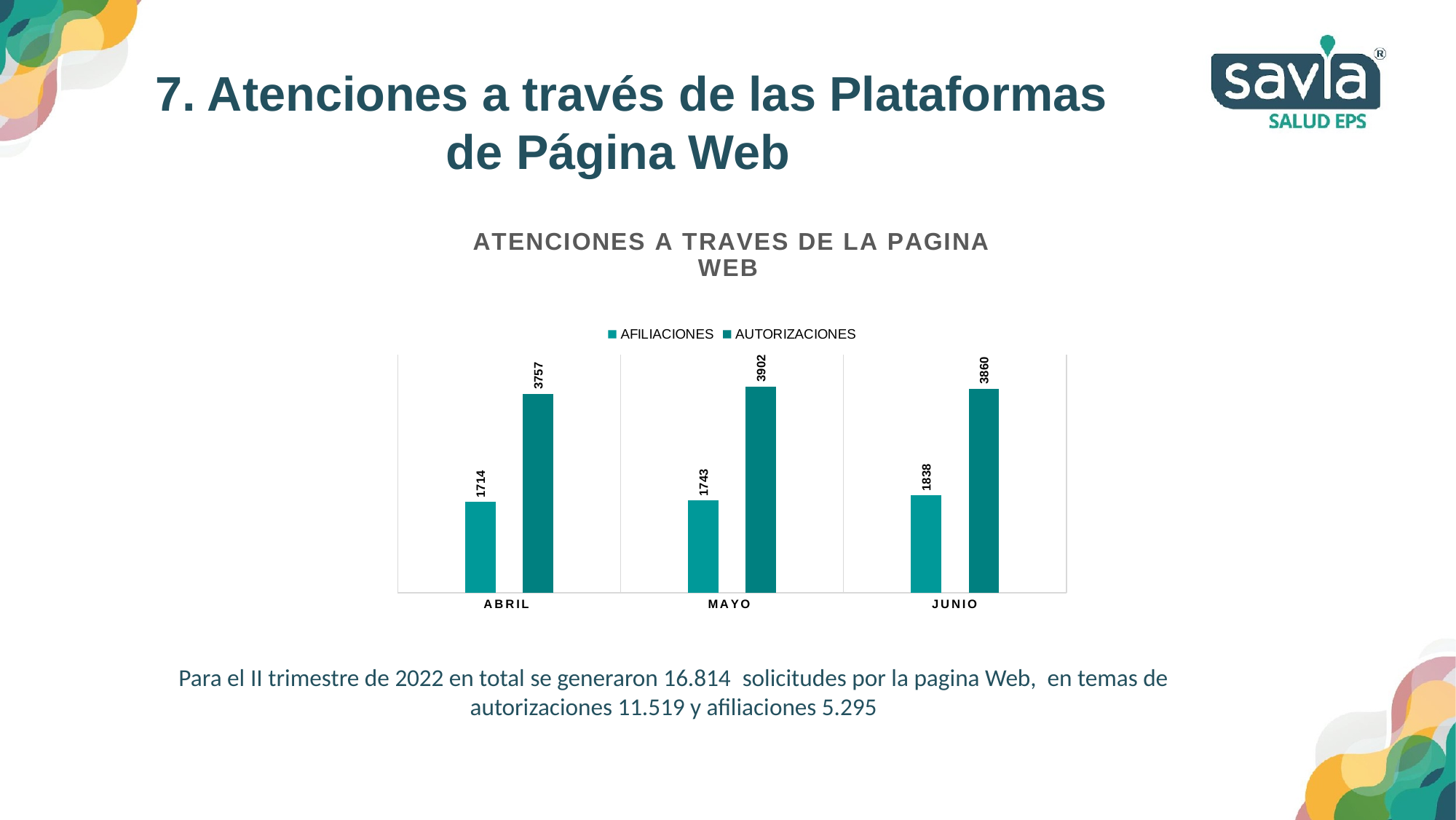
Which month has the highest AUTORIZACIONES value? MAYO Do the AFILIACIONES values rise or fall from ABRIL to JUNIO? Rise What is the difference between the AUTORIZACIONES values for MAYO and JUNIO? 42 What is the difference between AUTORIZACIONES and AFILIACIONES in ABRIL? 2043 How many series does the legend list? 2 How many months are shown on the x axis? 3 What kind of chart is shown? Bar chart What is the AFILIACIONES value for JUNIO? 1838 What is the AFILIACIONES value for ABRIL? 1714 Which is larger, AFILIACIONES in MAYO or AFILIACIONES in JUNIO? AFILIACIONES in JUNIO What is the AUTORIZACIONES value for MAYO? 3902 Which month has the lowest AFILIACIONES value? ABRIL